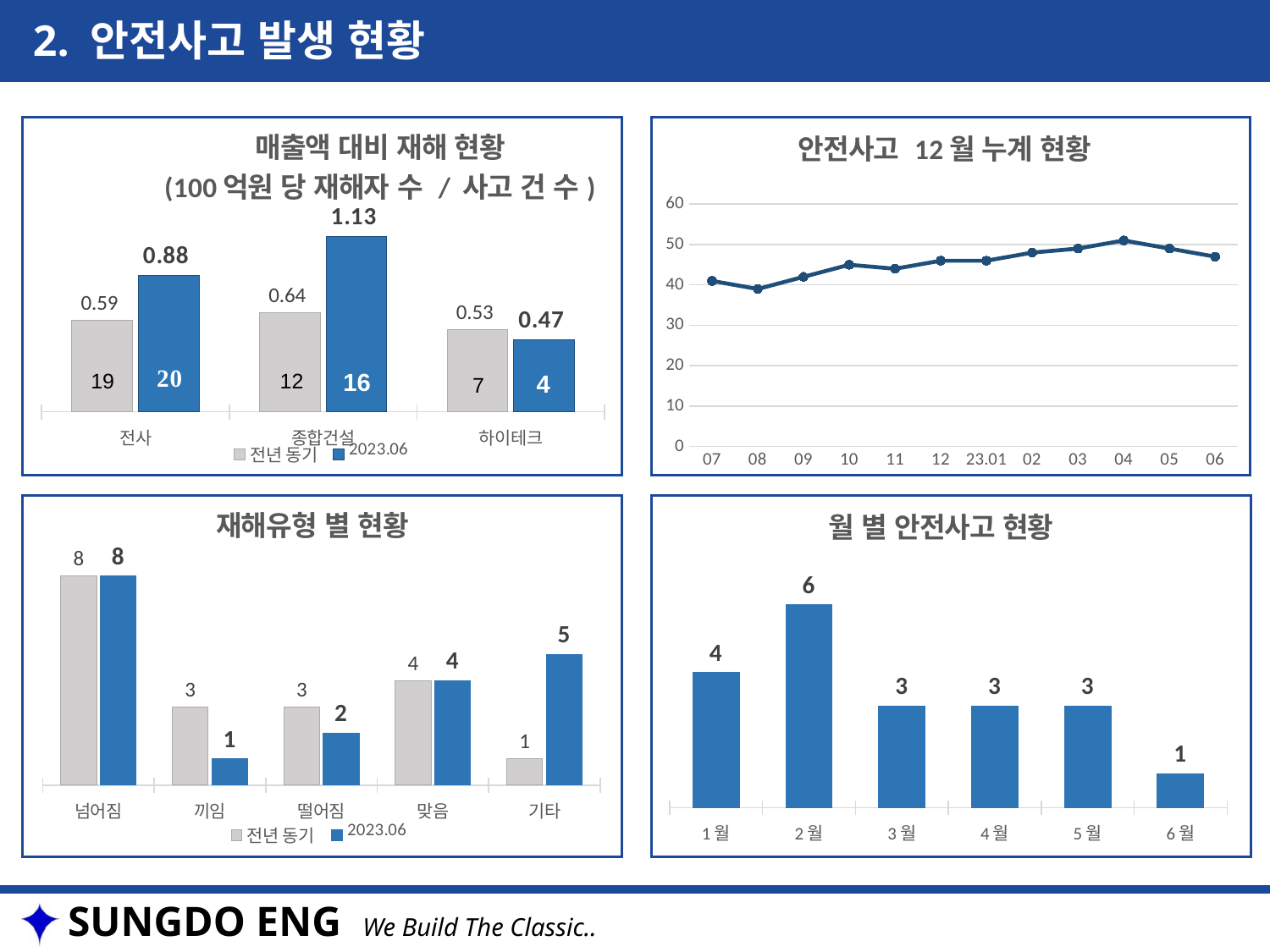
In the '재해유형 별 현황' chart, what is the 2023.06 value for 기타? 5 In the '월 별 안전사고 현황' chart, what is the difference between the values for 2월 and 1월? 2 What kind of chart is the '안전사고 12 월 누계 현황' chart? line chart How many data points are plotted in the '안전사고 12 월 누계 현황' chart? 12 In the '매출액 대비 재해 현황' chart, what is the 전년 동기 value for 하이테크? 0.53 How many series does the legend of the '매출액 대비 재해 현황' chart list? 2 In the '재해유형 별 현황' chart, what is the difference between the 전년 동기 and 2023.06 values for 끼임? 2 In the '월 별 안전사고 현황' chart, which month has the lowest value? 6월 In the '월 별 안전사고 현황' chart, which month has the highest value? 2월 In the '안전사고 12 월 누계 현황' chart, is the value for 04 greater or less than 40? greater In the '매출액 대비 재해 현황' chart, which is larger for 하이테크: the 전년 동기 value or the 2023.06 value? 전년 동기 In the '매출액 대비 재해 현황' chart, what is the 2023.06 value for 종합건설? 1.13